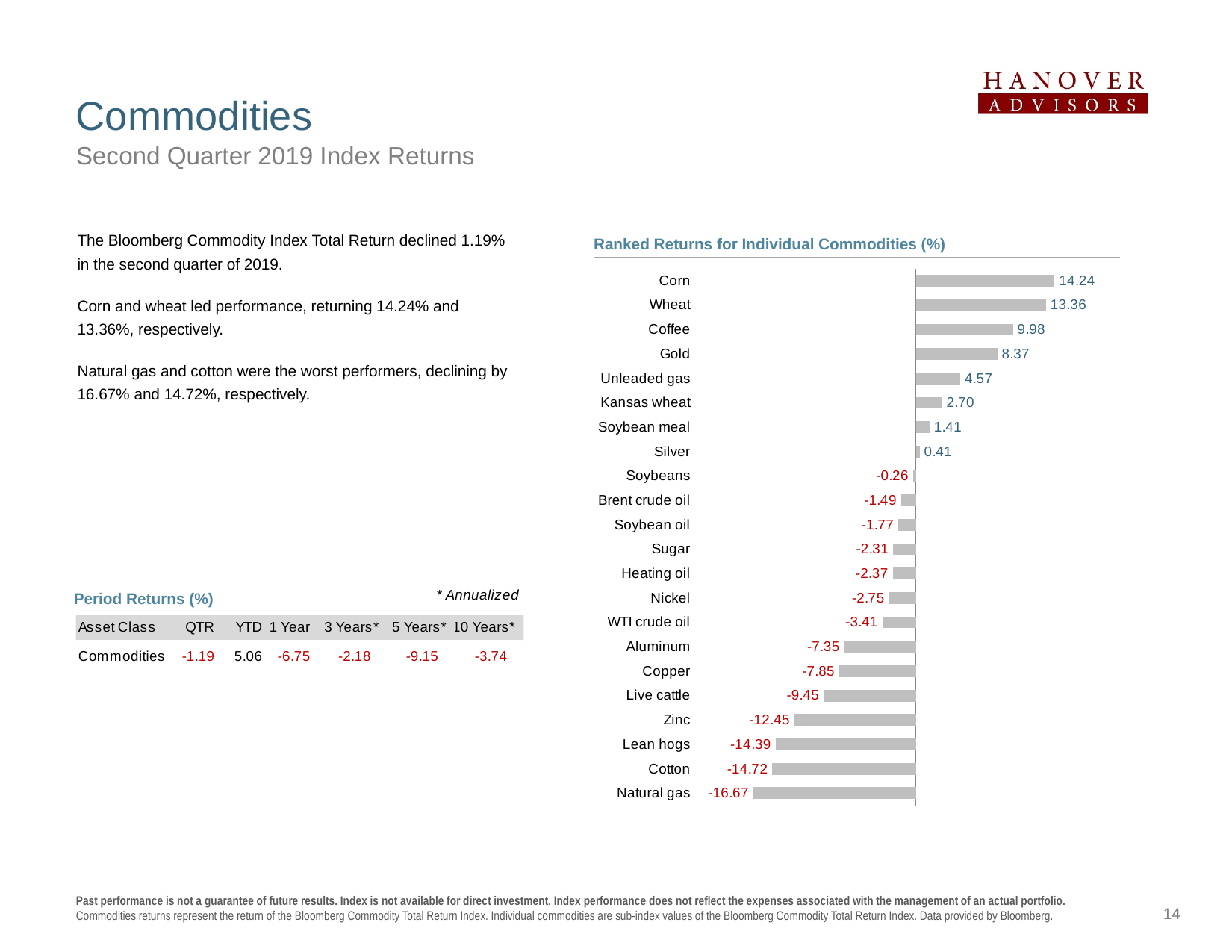
What is the difference between the returns for Gold and Unleaded gas in the Ranked Returns for Individual Commodities chart? 3.80 In the Ranked Returns for Individual Commodities chart, which has the larger return, Silver or Soybean meal? Soybean meal Which commodity has the highest return in the Ranked Returns for Individual Commodities chart? Corn How many commodities in the Ranked Returns for Individual Commodities chart have a positive return? 8 What is the return shown for Coffee in the Ranked Returns for Individual Commodities chart? 9.98 What is the return shown for Kansas wheat in the Ranked Returns for Individual Commodities chart? 2.70 What type of chart is the Ranked Returns for Individual Commodities chart? Bar chart What is the return shown for Zinc in the Ranked Returns for Individual Commodities chart? -12.45 In the Ranked Returns for Individual Commodities chart, which has the larger return, Copper or Aluminum? Aluminum Which commodity has the lowest return in the Ranked Returns for Individual Commodities chart? Natural gas What is the difference between the returns for Corn and Wheat in the Ranked Returns for Individual Commodities chart? 0.88 How many commodities are shown in the Ranked Returns for Individual Commodities chart? 22